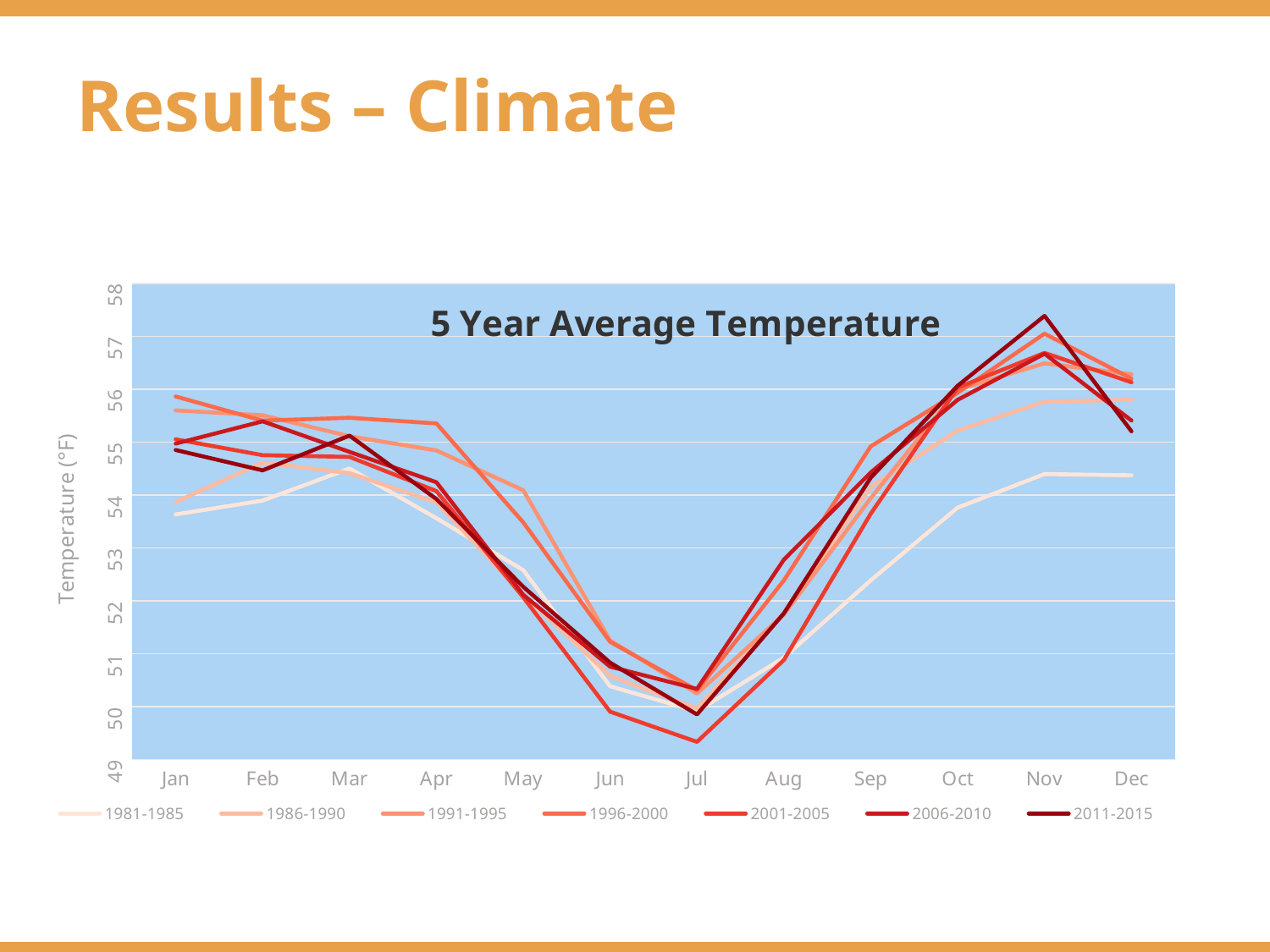
Do the temperatures rise or fall from Jan to Jul? fall In which month does the 2011-2015 series reach its highest value? Nov Is the value for 2011-2015 in Nov greater or less than 57? greater Which series has the lowest value in Jul? 2001-2005 Which series has the lowest value in Dec? 1981-1985 Is the value for 1981-1985 in Dec greater or less than 55? less What is the title of the chart? 5 Year Average Temperature How many months are plotted along the x axis? 12 What kind of chart is shown on the slide? Line chart How many series does the legend list? 7 Is the value for 2001-2005 in Jul greater or less than 50? less What is the label of the vertical axis? Temperature (°F)